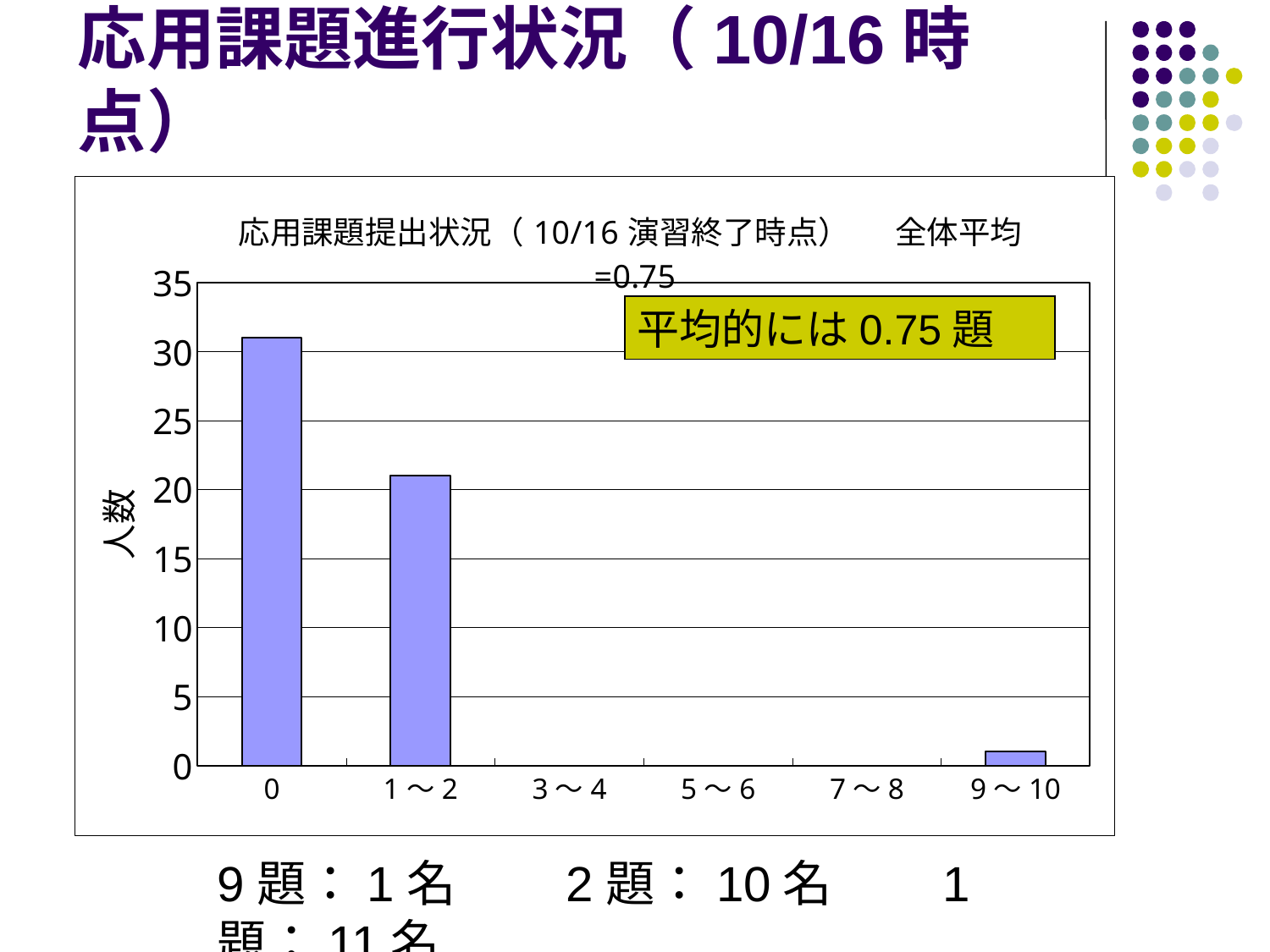
Is the value for category 1～2 greater or less than 25? less What kind of chart is shown on the slide? bar chart Is the value for category 9～10 greater or less than 5? less What is the label of the vertical axis of the chart? 人数 Is the value for category 0 greater or less than 30? greater Do the bar heights generally rise or fall moving from left to right along the x axis? fall How many categories are shown on the x axis of the chart? 6 What is the highest value shown on the vertical axis of the chart? 35 Which category has the tallest bar in the chart? 0 Which bar is taller, the one for 0 or the one for 1～2? 0